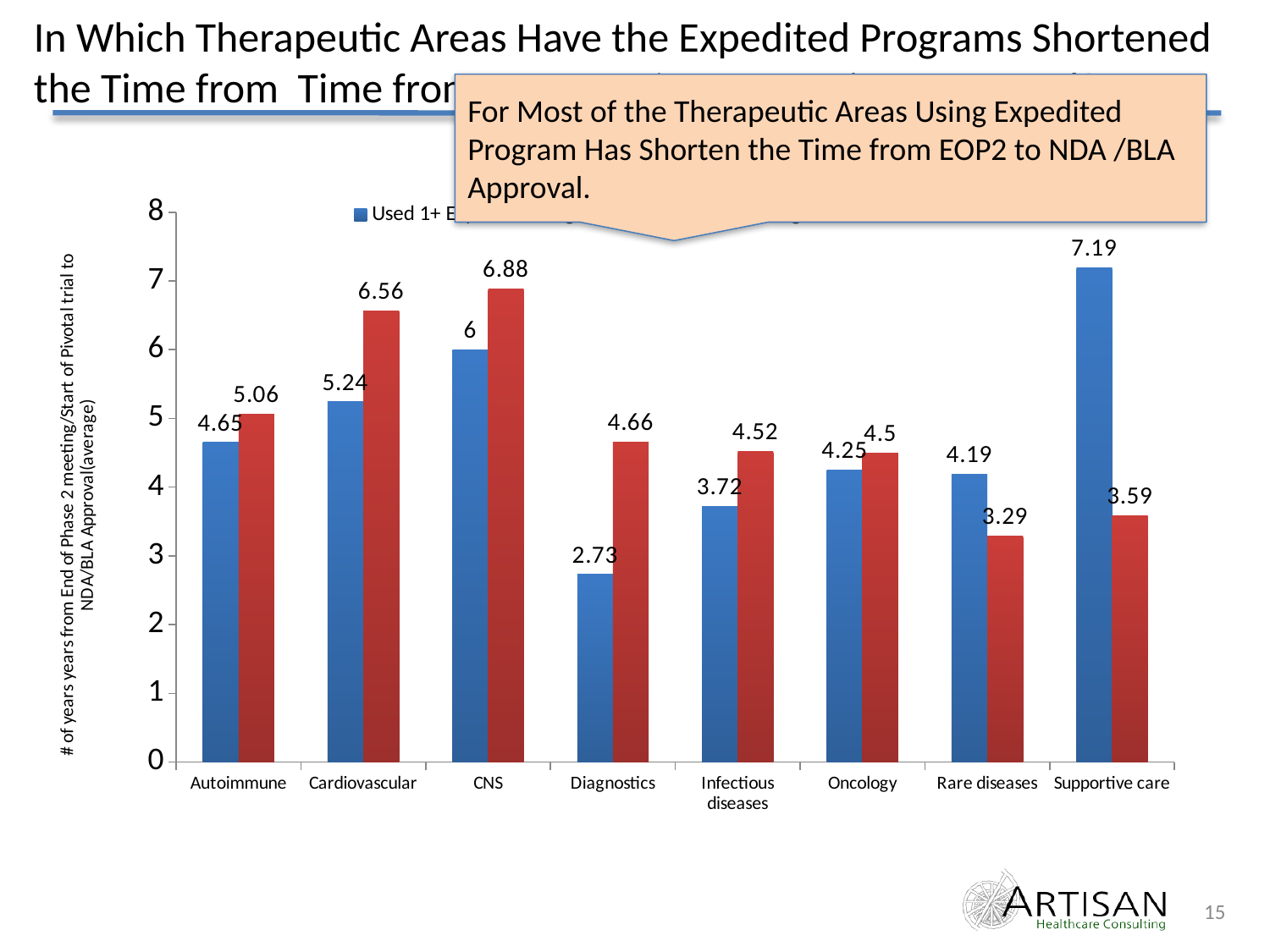
For Cardiovascular, which bar is larger, the blue or the red? red Is the blue bar for Infectious diseases greater or less than 4? less How many therapeutic areas are shown on the x axis? 8 What is the difference between the red and blue bars for Diagnostics? 1.93 For Rare diseases, which bar is larger, the blue or the red? blue What is the value of the red bar for CNS? 6.88 What kind of chart is shown on the slide? bar chart What is the value of the blue bar for Diagnostics? 2.73 Which therapeutic area has the highest blue bar? Supportive care What is the difference between the blue and red bars for Supportive care? 3.6 Which therapeutic area has the lowest red bar? Rare diseases What is the value of the blue bar for Supportive care? 7.19